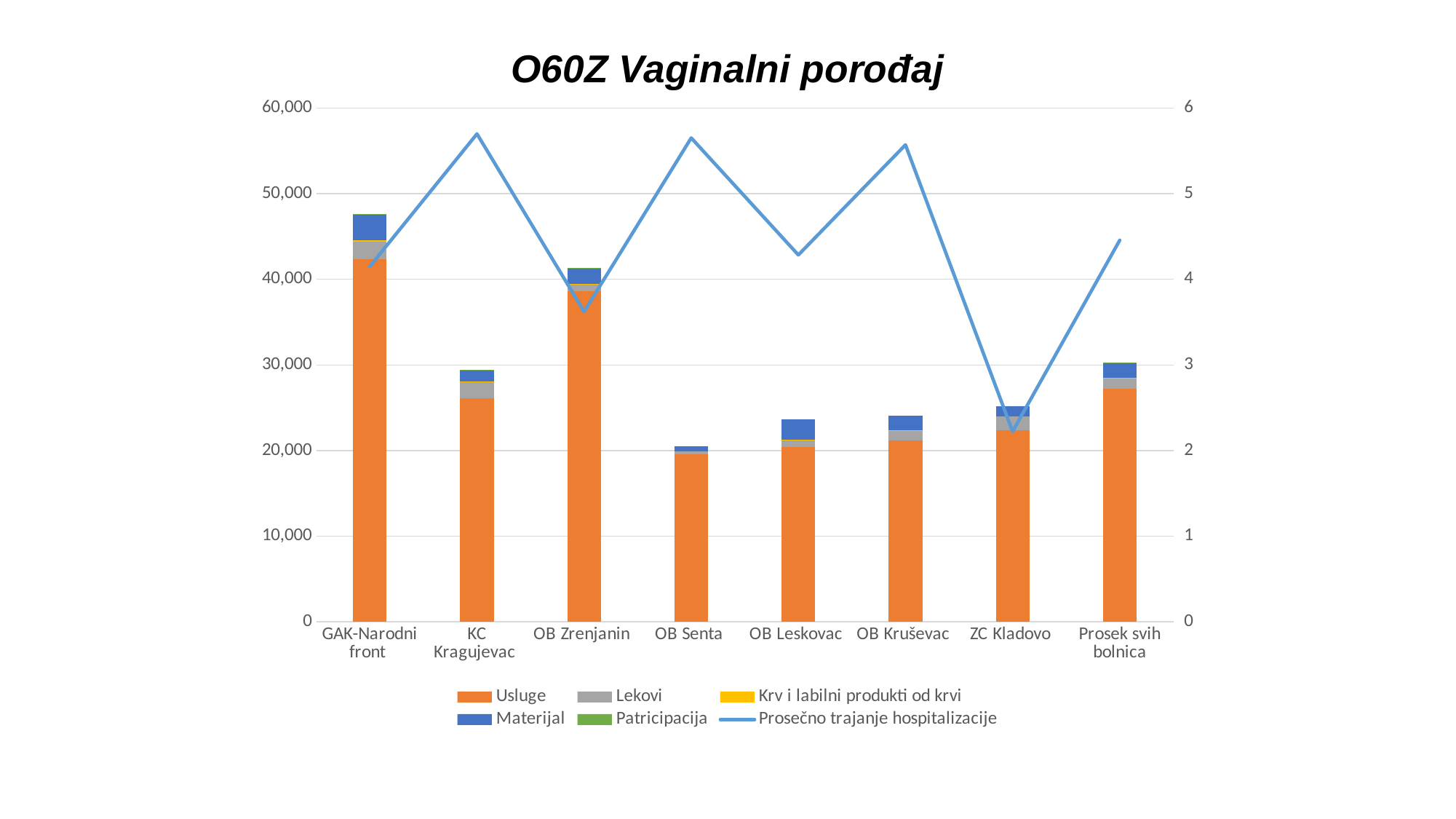
How many categories are shown on the x axis of the chart? 8 Which series is drawn as a line rather than as bars? Prosečno trajanje hospitalizacije Which category has the tallest stacked bar? GAK-Narodni front Which has the higher Prosečno trajanje hospitalizacije value, KC Kragujevac or OB Zrenjanin? KC Kragujevac Is the Prosečno trajanje hospitalizacije value for OB Zrenjanin greater or less than 4? less Is the Prosečno trajanje hospitalizacije value for OB Leskovac greater or less than 5? less What is the title of the chart? O60Z Vaginalni porođaj Is the total stacked bar for GAK-Narodni front greater or less than 40,000? greater How many series does the legend list? 6 Which category has the shortest stacked bar? OB Senta Which has the taller stacked bar, GAK-Narodni front or KC Kragujevac? GAK-Narodni front Which category has the lowest value on the Prosečno trajanje hospitalizacije line? ZC Kladovo